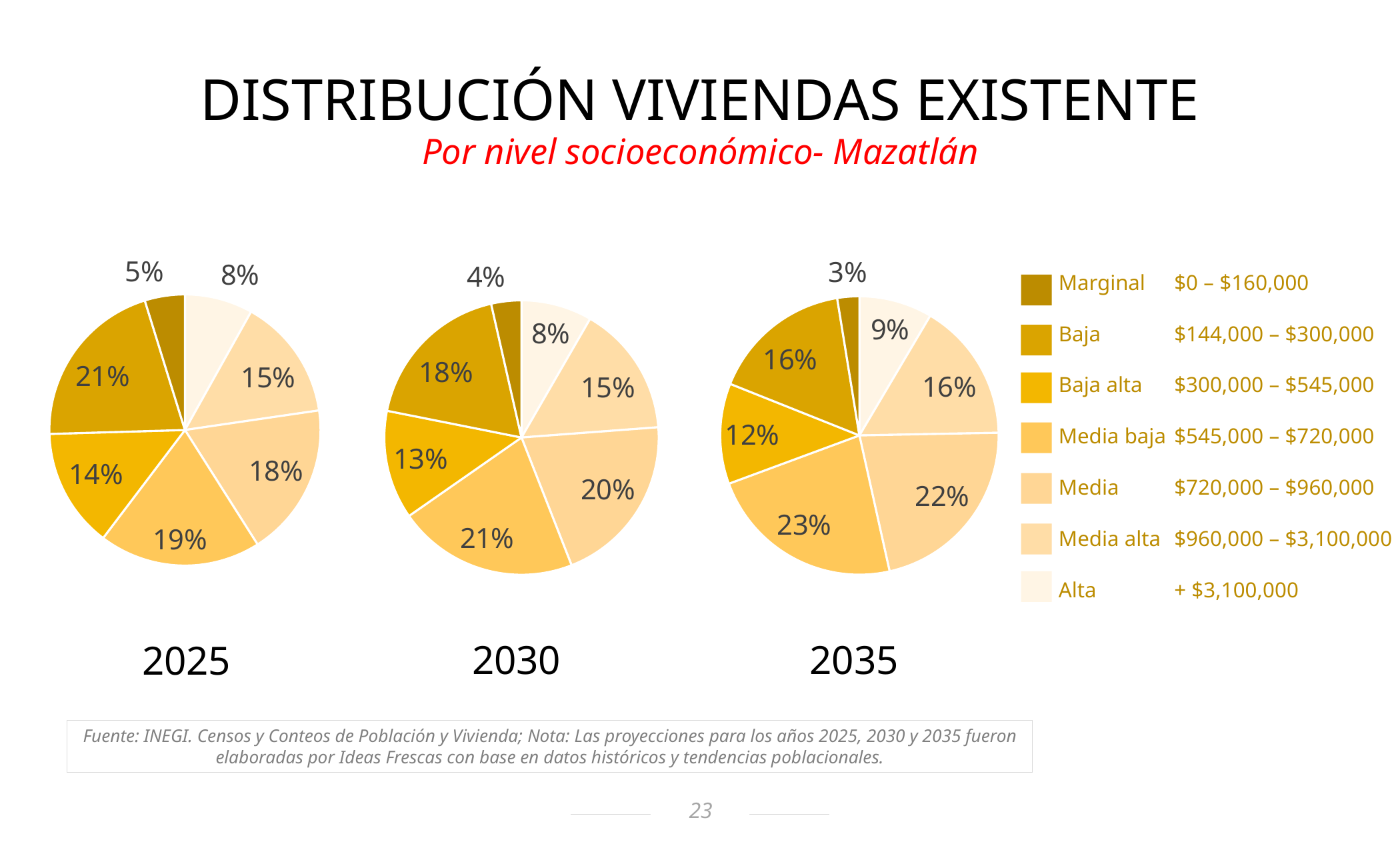
How many slices does each pie chart have? 7 In the 2035 pie chart, which is larger, the Baja slice or the Baja alta slice? Baja In the 2030 pie chart, which category has the smallest slice? Marginal In the 2030 pie chart, what share is labelled for the Media baja slice? 21% How many categories does the legend list? 7 In the 2035 pie chart, what share is labelled for the Media slice? 22% In the 2025 pie chart, what share is labelled for the Marginal slice? 5% In the 2025 pie chart, what is the difference between the Baja slice and the Baja alta slice? 7% In the 2035 pie chart, which category has the largest slice? Media baja According to the legend, what price range corresponds to the Media alta category? $960,000 – $3,100,000 What kind of charts are shown on the slide? Pie charts Across the 2025, 2030 and 2035 pie charts, does the Marginal share rise or fall over time? Fall